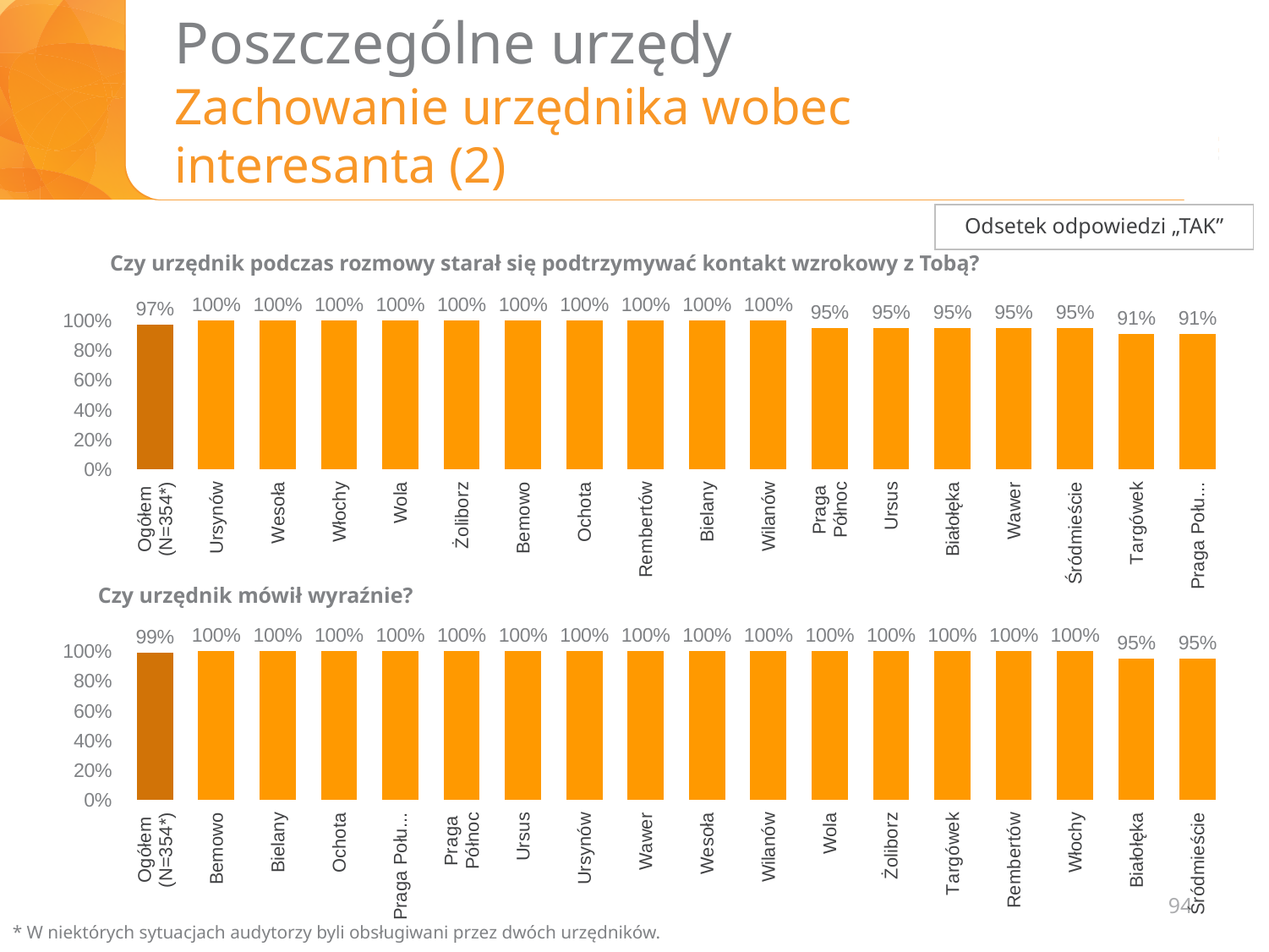
In the top chart ("Czy urzędnik podczas rozmowy starał się podtrzymywać kontakt wzrokowy z Tobą?"), what is the value for Targówek? 91% In the bottom chart ("Czy urzędnik mówił wyraźnie?"), what is the value for Rembertów? 100% According to the box in the top right of the slide, what do the percentages in the charts represent? Odsetek odpowiedzi „TAK” In the bottom chart ("Czy urzędnik mówił wyraźnie?"), what is the difference between the values for Bemowo and Śródmieście? 5 percentage points In the top chart ("Czy urzędnik podczas rozmowy starał się podtrzymywać kontakt wzrokowy z Tobą?"), what is the value for Ogółem (N=354*)? 97% In the top chart ("Czy urzędnik podczas rozmowy starał się podtrzymywać kontakt wzrokowy z Tobą?"), how many categories are shown on the x axis? 18 In the top chart ("Czy urzędnik podczas rozmowy starał się podtrzymywać kontakt wzrokowy z Tobą?"), what is the difference between the values for Ursynów and Targówek? 9 percentage points In the top chart ("Czy urzędnik podczas rozmowy starał się podtrzymywać kontakt wzrokowy z Tobą?"), what is the value for Ursus? 95% In the bottom chart ("Czy urzędnik mówił wyraźnie?"), what is the value for Białołęka? 95% In the top chart ("Czy urzędnik podczas rozmowy starał się podtrzymywać kontakt wzrokowy z Tobą?"), which is larger, the value for Wawer or the value for Targówek? Wawer What type of chart is the bottom chart ("Czy urzędnik mówił wyraźnie?")? Bar chart In the bottom chart ("Czy urzędnik mówił wyraźnie?"), what is the value for Ogółem (N=354*)? 99%